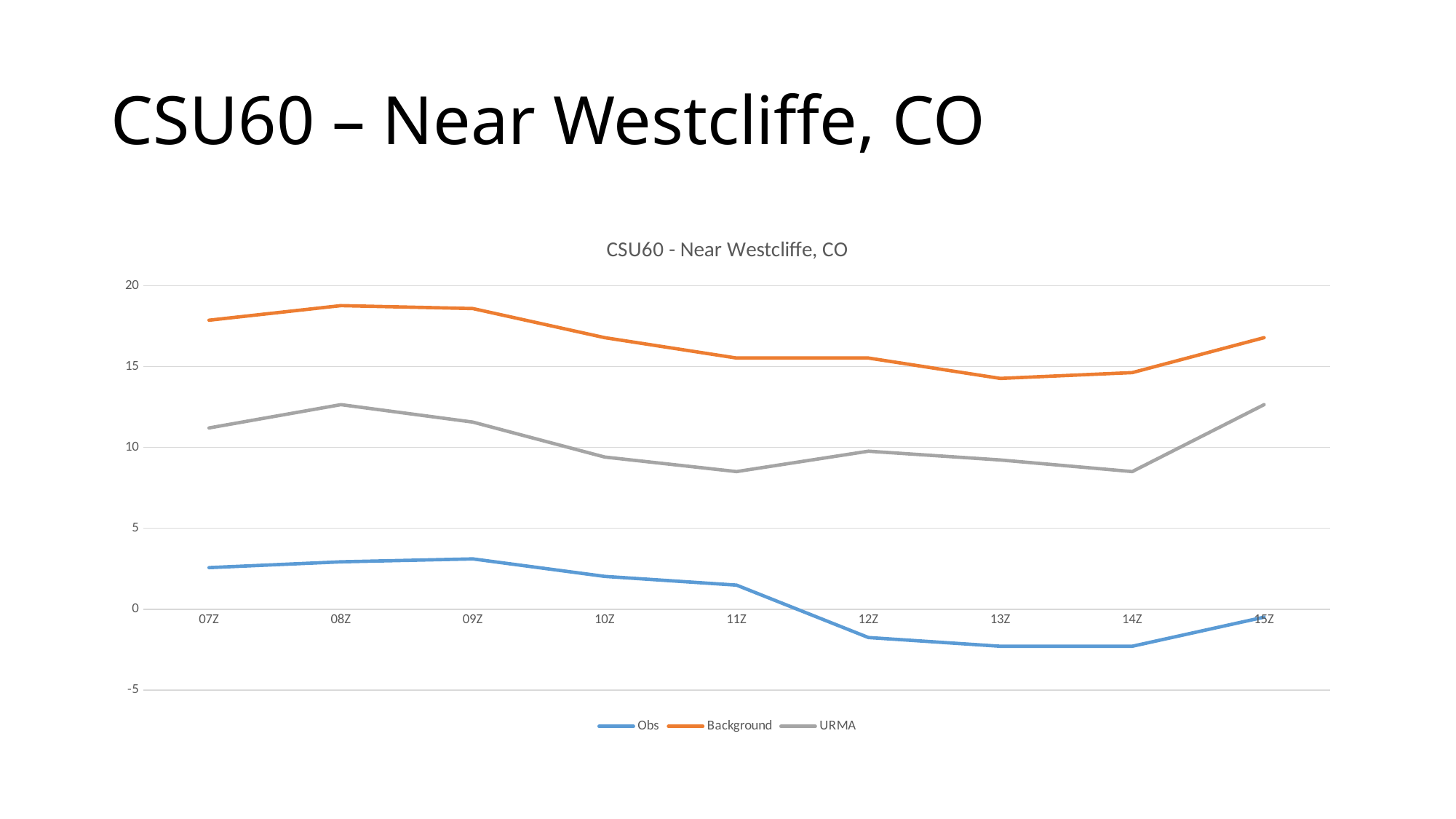
Is the URMA value at 08Z greater or less than 10? greater Is the Background value at 07Z greater or less than 15? greater What is the title of the chart? CSU60 - Near Westcliffe, CO Which series is drawn in orange? Background At 15Z, which series has the larger value, Obs or URMA? URMA Is the Obs value at 12Z greater or less than 0? less At 07Z, which series has the larger value, Background or URMA? Background What kind of chart is shown on the slide? line chart Does the Obs line rise or fall from 09Z to 13Z? fall How many time points are plotted along the x axis? 9 How many series does the legend list? 3